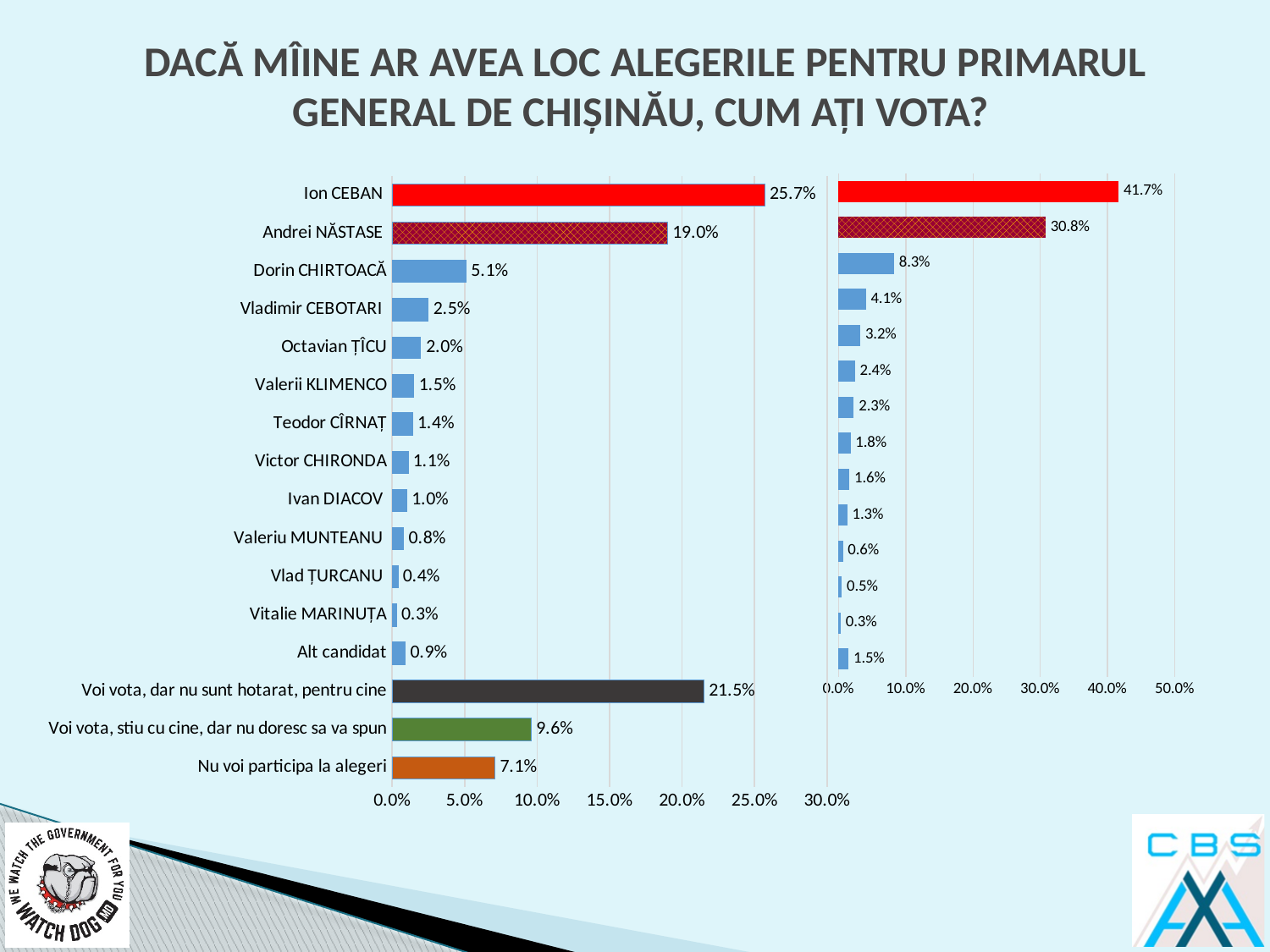
On the left chart, what is the value for Ion CEBAN? 25.7% On the left chart, what is the value for Andrei NĂSTASE? 19.0% On the left chart, what is the value for 'Voi vota, dar nu sunt hotarat, pentru cine'? 21.5% How many categories does the left chart show? 16 On the left chart, which category has the highest value? Ion CEBAN On the left chart, what is the difference between the values for Ion CEBAN and Andrei NĂSTASE? 6.7% On the left chart, what is the value for 'Nu voi participa la alegeri'? 7.1% On the left chart, which category has the lowest value? Vitalie MARINUȚA On the left chart, which is larger: the value for Dorin CHIRTOACĂ or the value for Vladimir CEBOTARI? Dorin CHIRTOACĂ What type of chart is the left chart? bar chart On the left chart, is the value for 'Voi vota, stiu cu cine, dar nu doresc sa va spun' greater or less than 10.0%? less On the right chart, what is the value of the top (longest) bar? 41.7%